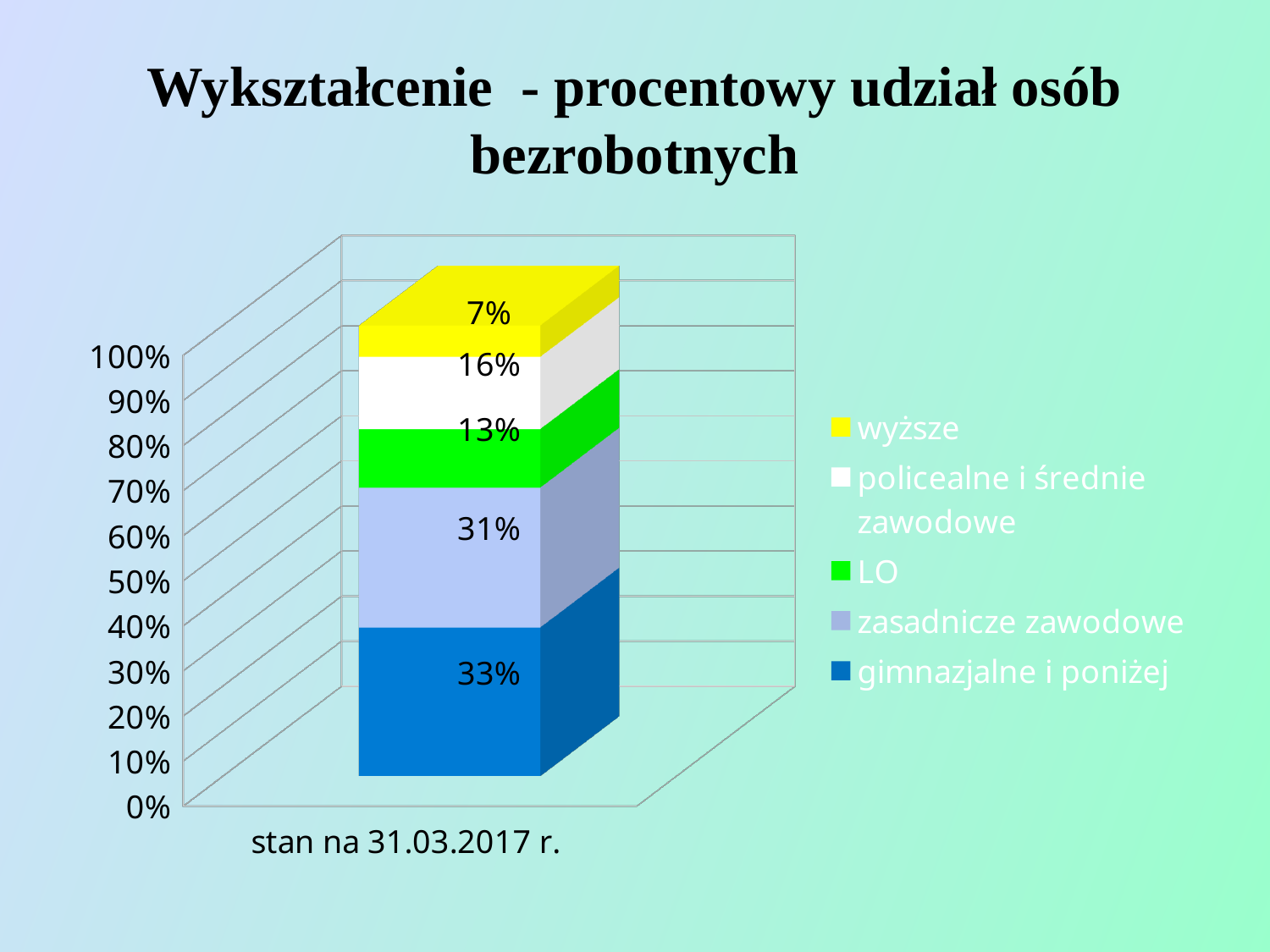
What is the value for 'gimnazjalne i poniżej'? 33% Which is larger, the value for 'LO' or for 'policealne i średnie zawodowe'? policealne i średnie zawodowe What is the difference between the 'gimnazjalne i poniżej' and 'wyższe' values? 26% What is the category label shown under the bar? stan na 31.03.2017 r. What kind of chart is shown on the slide? stacked bar chart Which education category has the largest share? gimnazjalne i poniżej Which education category has the smallest share? wyższe What percentage of unemployed persons have 'wyższe' education? 7% What is the value for 'policealne i średnie zawodowe'? 16% How many series does the legend list? 5 What is the value for 'LO'? 13% What is the value for 'zasadnicze zawodowe'? 31%